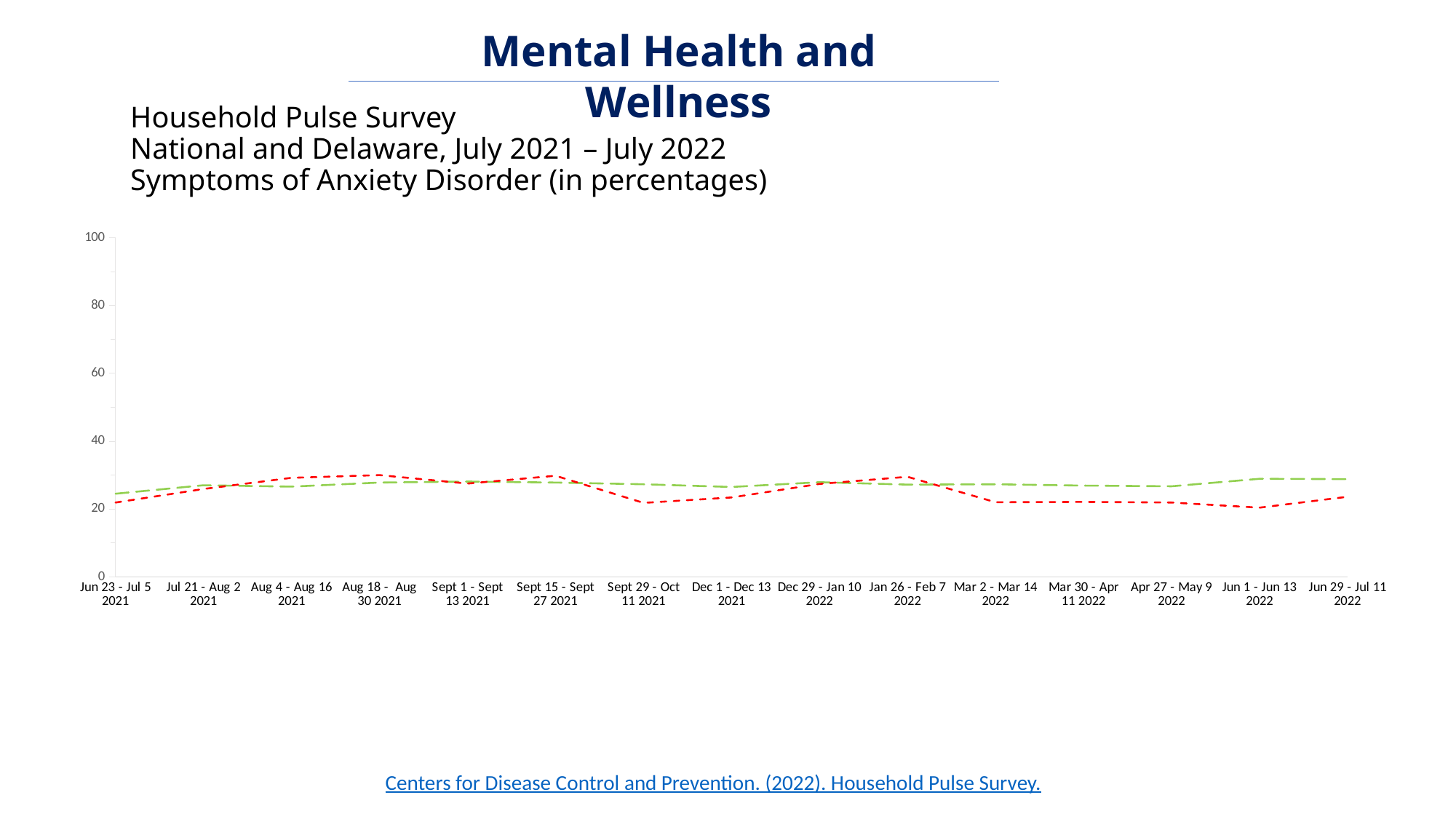
Is the value of the red dashed line for Aug 18 - Aug 30 2021 greater or less than 40? less For Jun 1 - Jun 13 2022, which line has the higher value, the red dashed line or the green dashed line? green dashed line How many survey periods are shown along the x axis of the chart? 15 Is the value of the green dashed line for Jun 29 - Jul 11 2022 greater or less than 20? greater What is the first survey period shown on the x axis of the chart? Jun 23 - Jul 5 2021 What kind of chart is shown on the slide? line chart For Jan 26 - Feb 7 2022, which line has the higher value, the red dashed line or the green dashed line? red dashed line How many lines are plotted on the chart? 2 For Sept 29 - Oct 11 2021, which line has the higher value, the red dashed line or the green dashed line? green dashed line What is the highest value labelled on the chart's vertical axis? 100 Is the value of the green dashed line for Jan 26 - Feb 7 2022 greater or less than 60? less